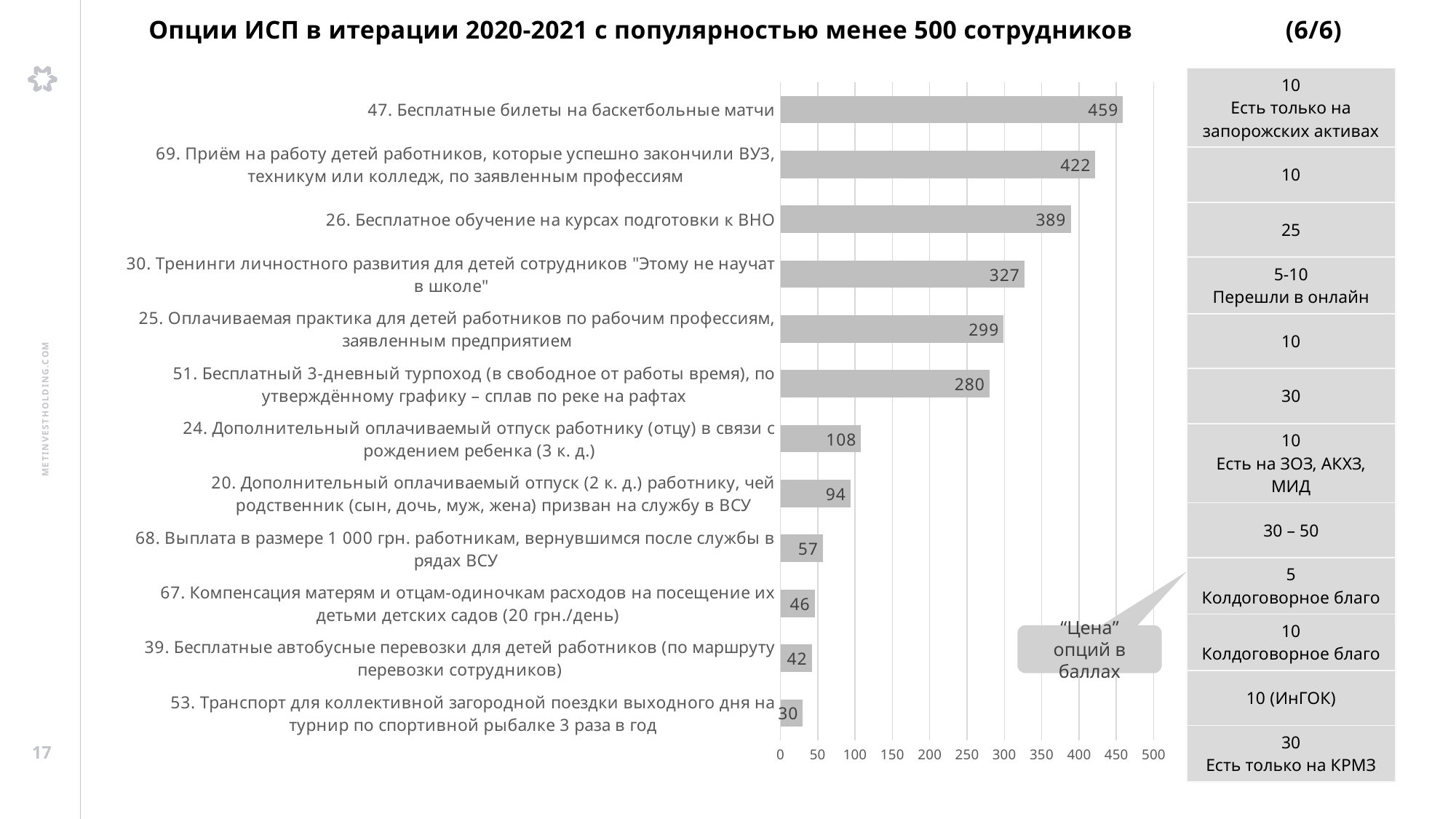
What is the value for "26. Бесплатное обучение на курсах подготовки к ВНО"? 389 What kind of chart is shown on the slide? Bar chart Which category has the lowest value on the chart? 53. Транспорт для коллективной загородной поездки выходного дня на турнир по спортивной рыбалке 3 раза в год What is the value for "68. Выплата в размере 1 000 грн. работникам, вернувшимся после службы в рядах ВСУ"? 57 What is the difference between the values for option 47 (Бесплатные билеты на баскетбольные матчи) and option 69 (Приём на работу детей работников)? 37 What is the value for "47. Бесплатные билеты на баскетбольные матчи"? 459 How many categories are plotted on the chart? 12 Which has a larger value: option 24 (Дополнительный оплачиваемый отпуск работнику (отцу)) or option 20 (Дополнительный оплачиваемый отпуск (2 к. д.))? 24. Дополнительный оплачиваемый отпуск работнику (отцу) в связи с рождением ребенка (3 к. д.) What is the difference between the values for option 51 (Бесплатный 3-дневный турпоход) and option 53 (Транспорт для коллективной загородной поездки)? 250 What is the title of the slide containing the chart? Опции ИСП в итерации 2020-2021 с популярностью менее 500 сотрудников Is the value for "30. Тренинги личностного развития для детей сотрудников" greater or less than 300? greater Which category has the highest value on the chart? 47. Бесплатные билеты на баскетбольные матчи